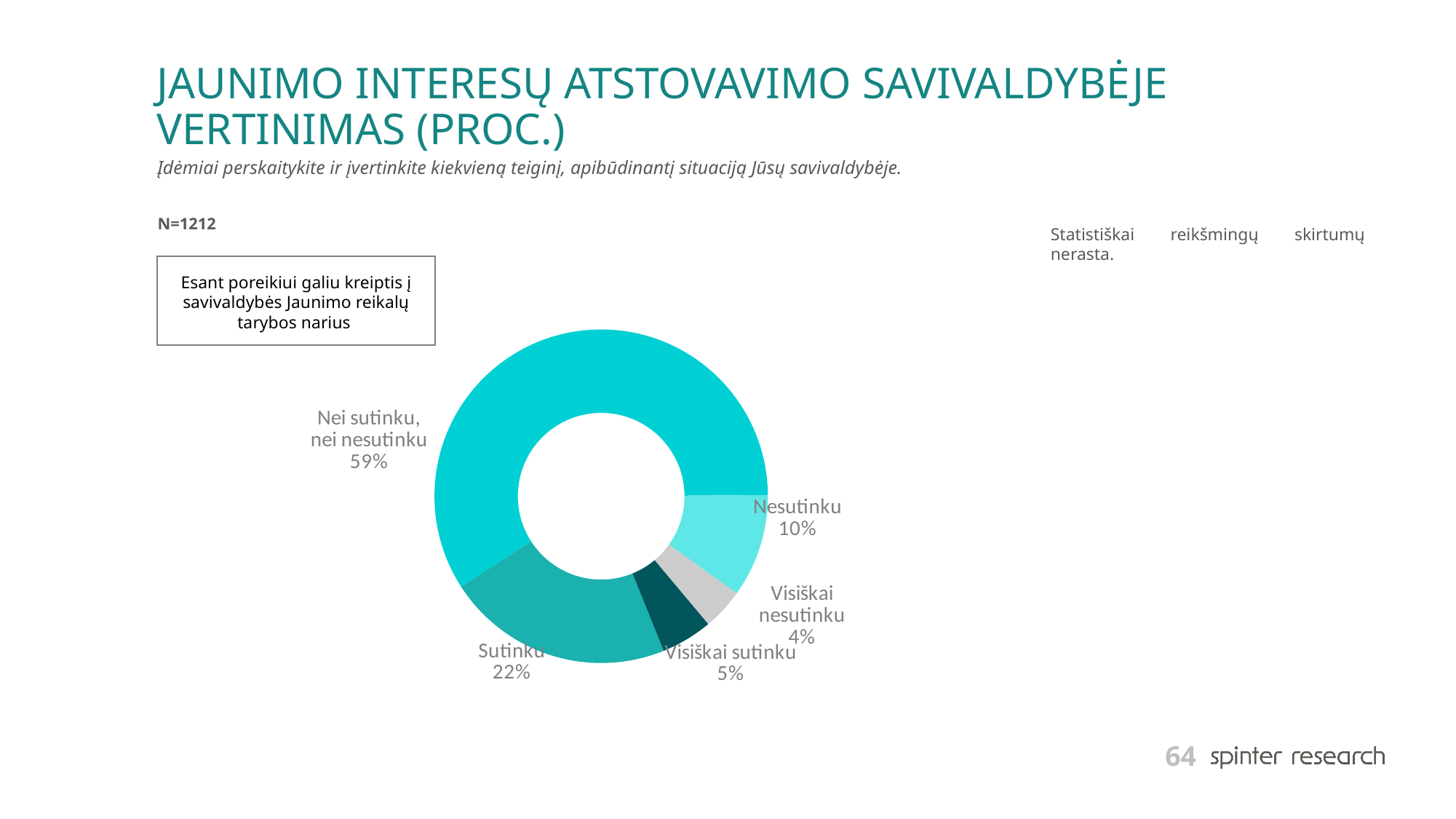
What type of chart is shown on the slide? Doughnut chart Which response category has the largest share of the chart? Nei sutinku, nei nesutinku What percentage of respondents answered "Sutinku"? 22% What is the difference in percentage points between "Nei sutinku, nei nesutinku" and "Sutinku"? 37 How many response categories are shown in the chart? 5 What percentage of respondents answered "Nesutinku"? 10% Which response category has the smallest share of the chart? Visiškai nesutinku What percentage of respondents answered "Nei sutinku, nei nesutinku"? 59% Which is larger: the share for "Sutinku" or the share for "Nesutinku"? Sutinku What percentage of respondents answered "Visiškai sutinku"? 5% What is the sample size (N) stated on the slide? N=1212 What percentage of respondents answered "Visiškai nesutinku"? 4%